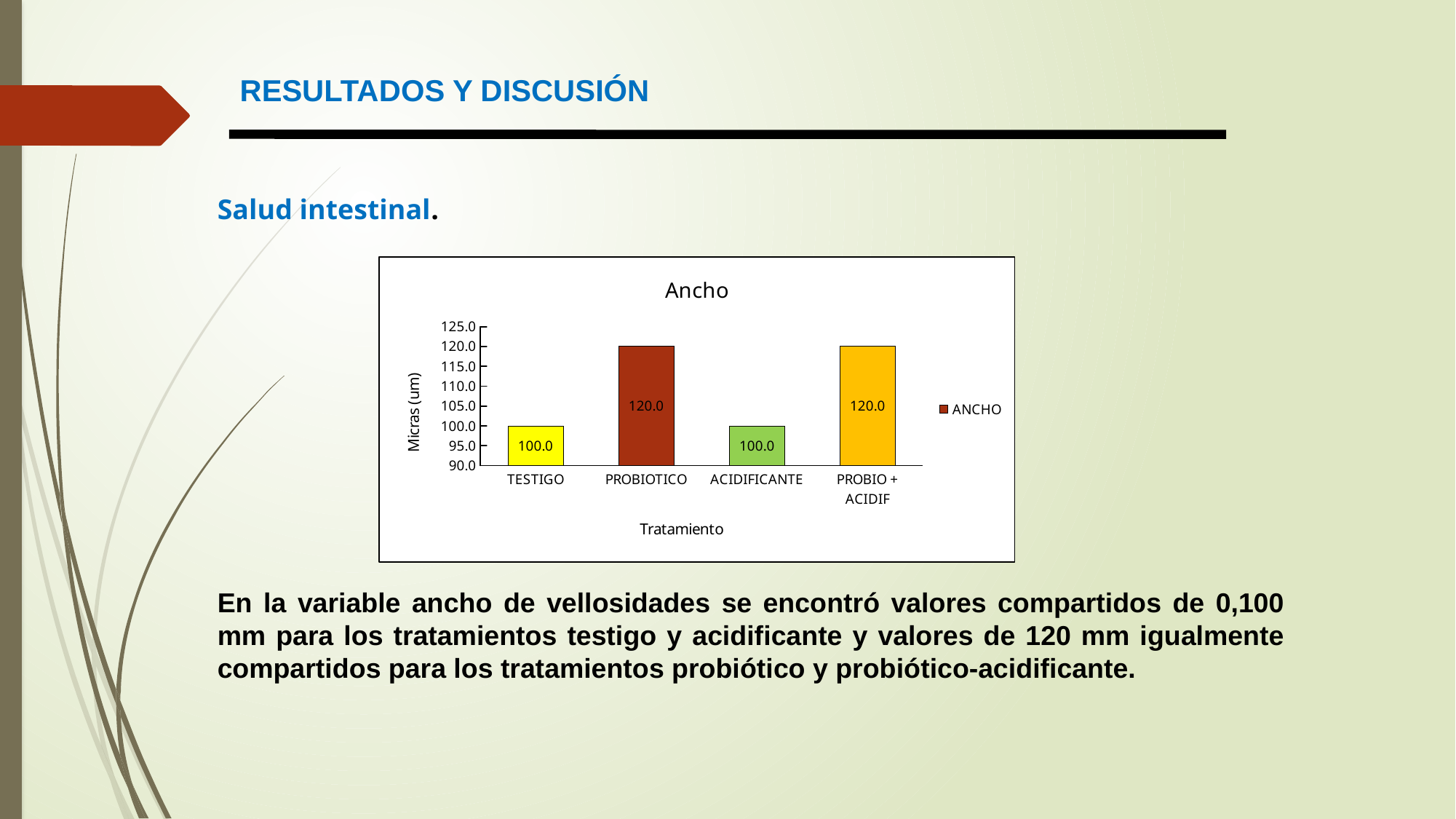
What is the value for TESTIGO? 100.0 What is the value for PROBIOTICO? 120.0 What is the label of the y axis? Micras (um) What is the title of the chart? Ancho Is the value for PROBIOTICO greater or less than 110.0? greater What kind of chart is shown? bar chart How many series does the legend list? 1 What is the value for ACIDIFICANTE? 100.0 How many treatment categories are shown on the x axis? 4 What is the difference between the values for PROBIOTICO and TESTIGO? 20.0 What is the value for PROBIO + ACIDIF? 120.0 Which is larger, the value for PROBIO + ACIDIF or the value for ACIDIFICANTE? PROBIO + ACIDIF